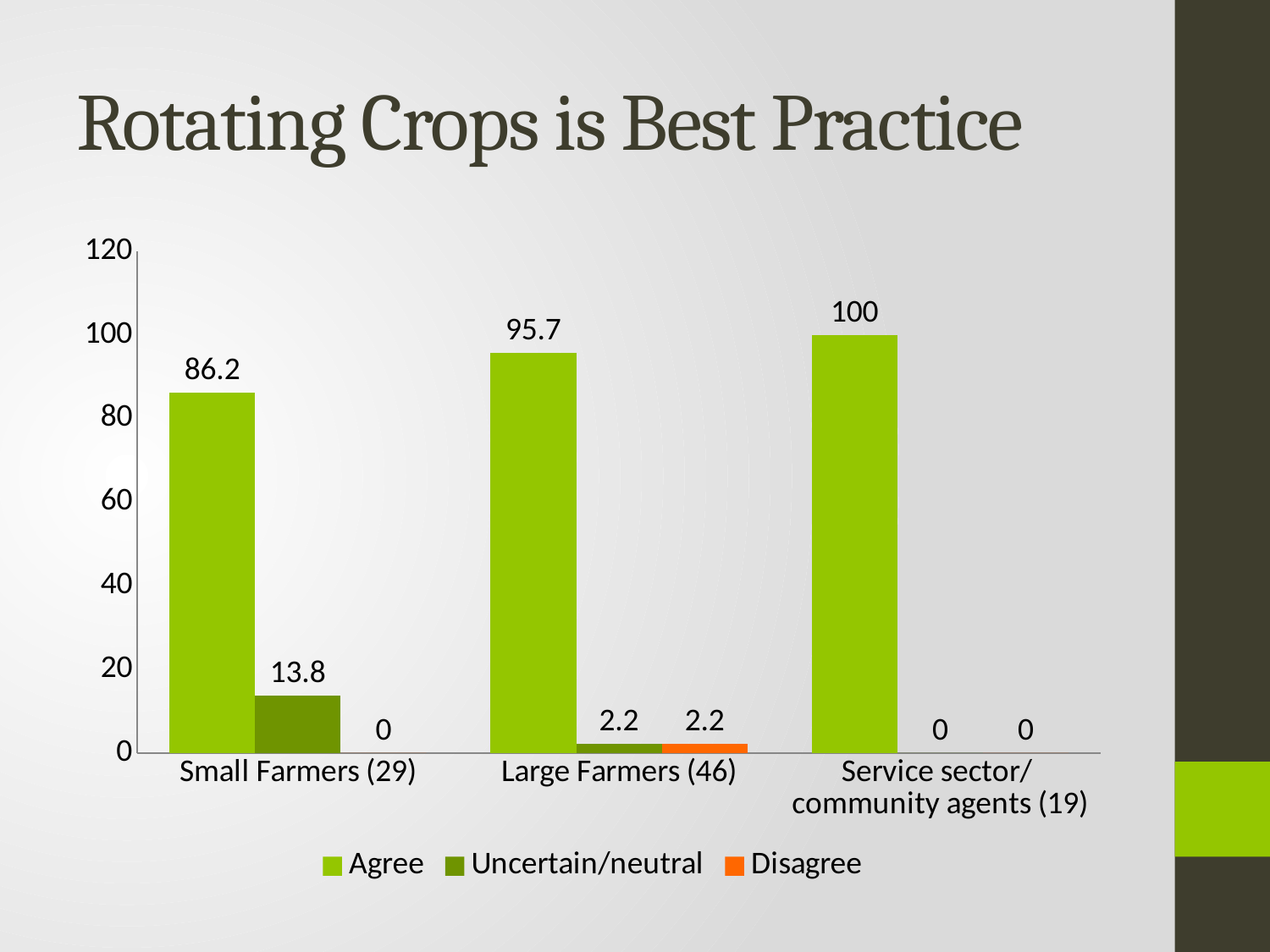
What is the Disagree value for Small Farmers (29)? 0 How many categories are shown on the x axis? 3 What is the Agree value for Service sector/community agents (19)? 100 What is the Agree value for Small Farmers (29)? 86.2 What kind of chart is shown on the slide? Bar chart What is the Uncertain/neutral value for Large Farmers (46)? 2.2 Which category has the lowest Agree value? Small Farmers (29) How many series does the legend list? 3 What is the title of the slide? Rotating Crops is Best Practice Which is larger, the Uncertain/neutral value for Small Farmers (29) or for Large Farmers (46)? Small Farmers (29) Which category has the highest Agree value? Service sector/community agents (19) What is the difference between the Agree values for Large Farmers (46) and Small Farmers (29)? 9.5